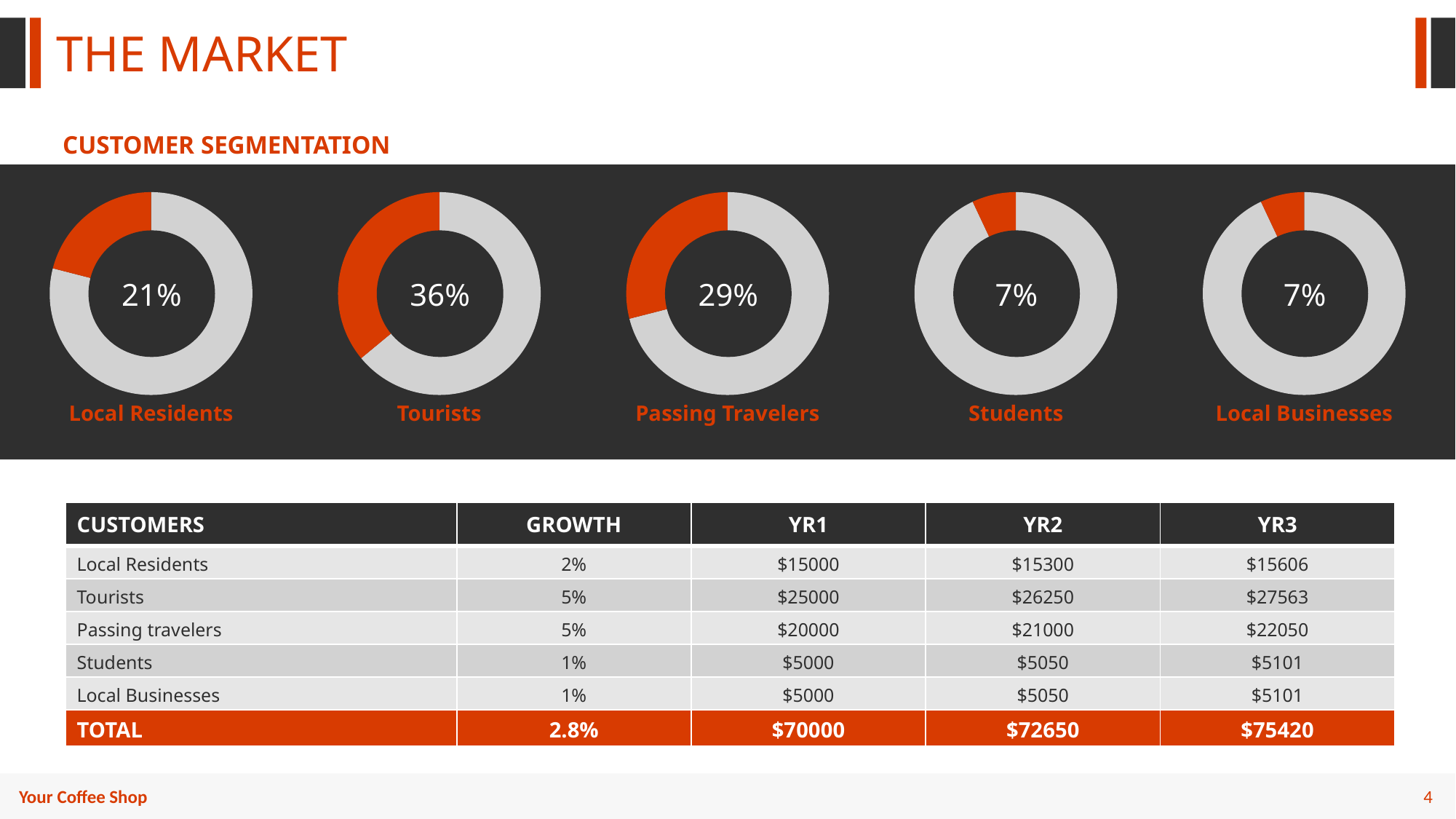
What percentage is shown in the Local Residents donut chart? 21% What percentage is shown in the Local Businesses donut chart? 7% What is the difference between the Tourists percentage and the Local Residents percentage in the donut charts? 15% What is the difference between the Tourists percentage and the Students percentage in the donut charts? 29% What colour is used for the filled segment in each donut chart? Orange What kind of charts are used in the Customer Segmentation section? Donut charts What percentage is shown in the Tourists donut chart? 36% What percentage is shown in the Students donut chart? 7% How many donut charts are shown in the Customer Segmentation section? 5 Which customer segment has the highest percentage among the donut charts? Tourists Which is larger in the donut charts, the Passing Travelers percentage or the Local Residents percentage? Passing Travelers What percentage is shown in the Passing Travelers donut chart? 29%